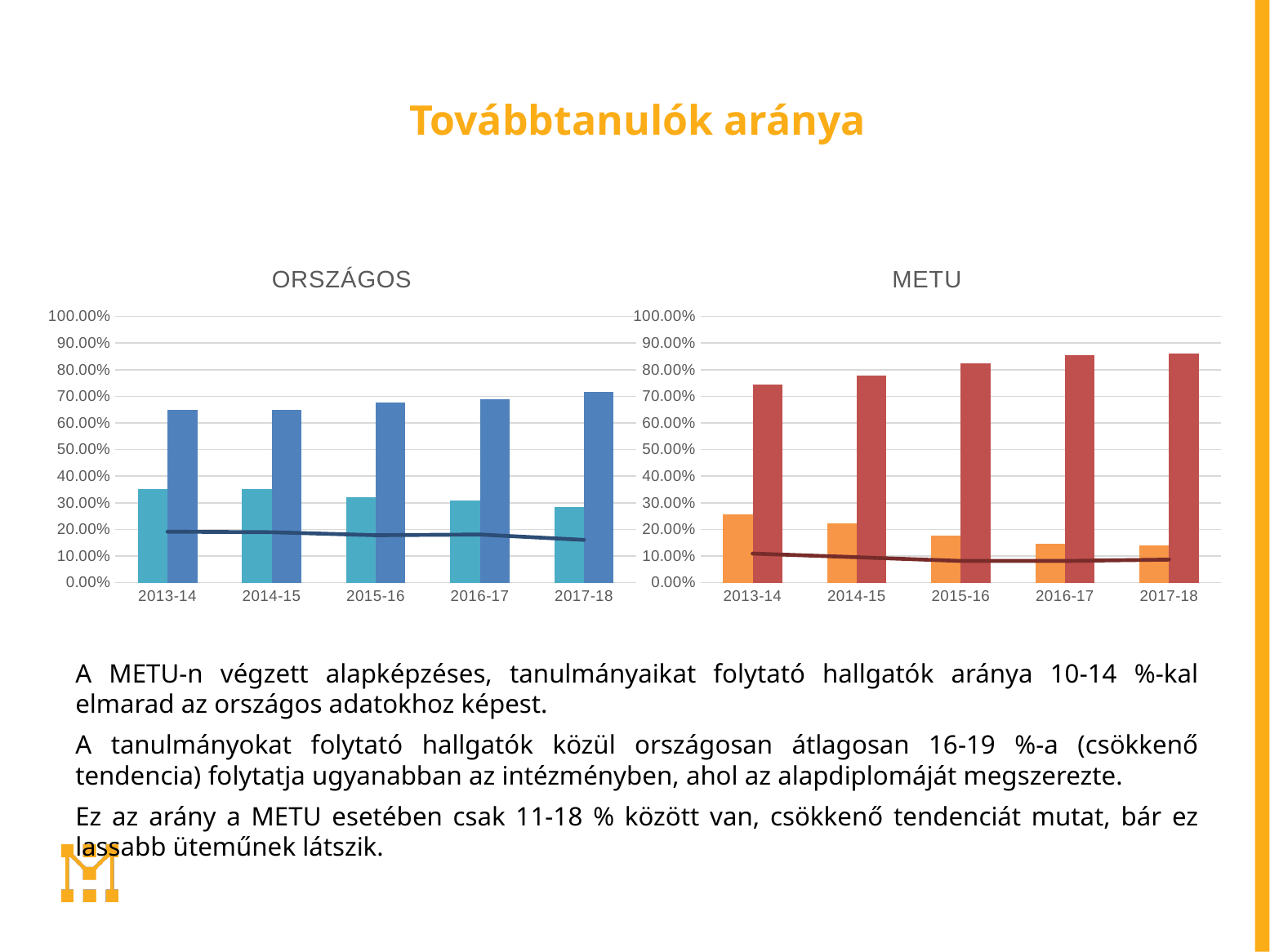
In the METU chart, which year has the highest orange bar? 2013-14 How many categories are shown on the x axis of the METU chart? 5 In the METU chart, is the orange bar for 2017-18 greater or less than 20%? less In the METU chart, do the dark red bars rise or fall from 2013-14 to 2017-18? rise What kind of chart is the ORSZÁGOS chart? combination bar and line chart What is the title of the chart on the right side of the slide? METU In the ORSZÁGOS chart, which is larger: the dark blue bar for 2013-14 or the dark blue bar for 2017-18? 2017-18 In the METU chart, is the orange bar for 2013-14 greater or less than 20%? greater In the ORSZÁGOS chart, which year has the lowest light blue bar? 2017-18 In the METU chart, is the dark red bar for 2017-18 greater or less than 80%? greater In the ORSZÁGOS chart, do the light blue bars rise or fall from 2013-14 to 2017-18? fall